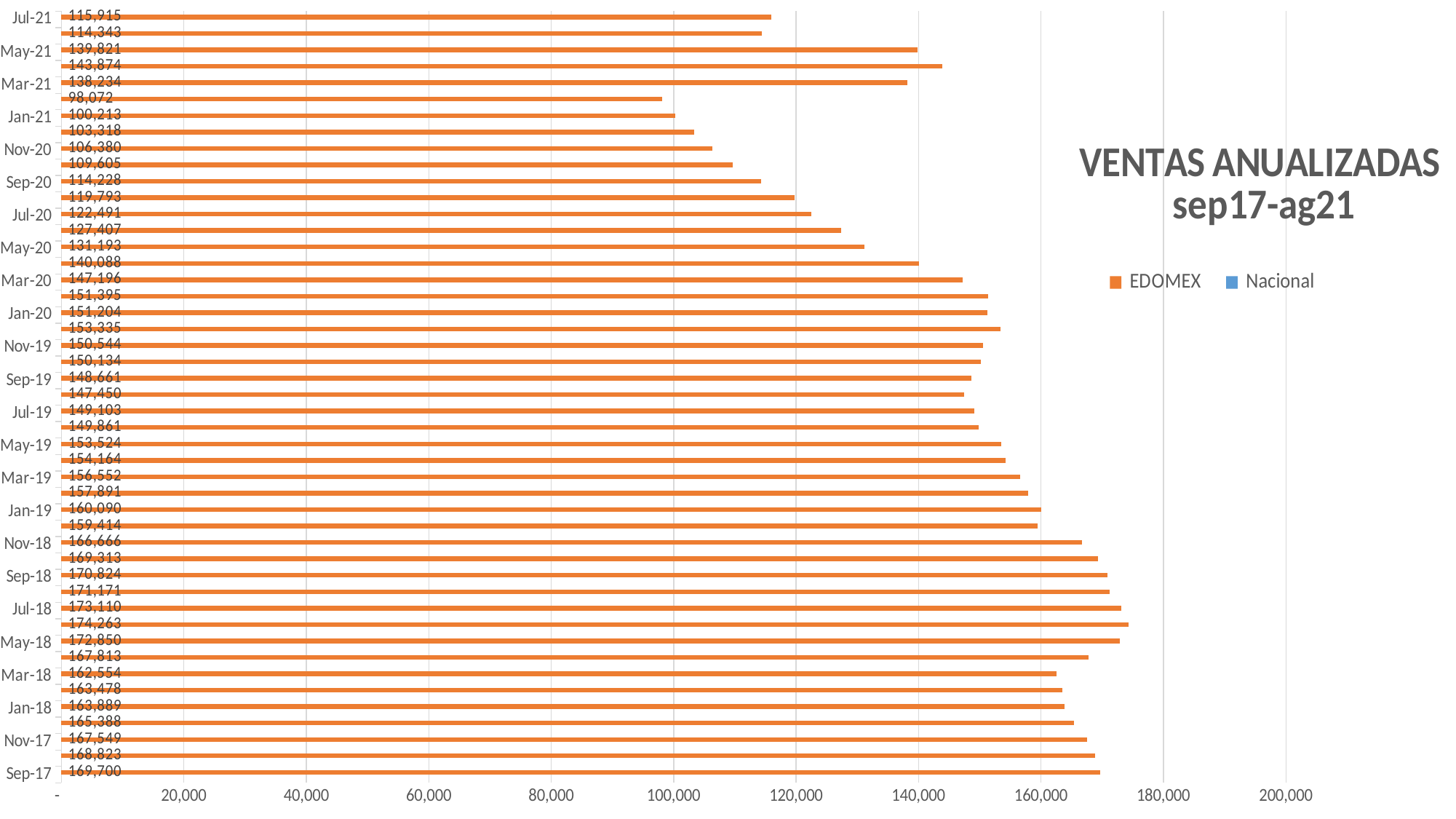
What is the EDOMEX value for Mar-21? 138,234 Do the EDOMEX values increase or decrease from Sep-20 to Jan-21? decrease What is the EDOMEX value for Sep-17? 169,700 Which is larger, the EDOMEX value for Jan-19 or for Jan-21? Jan-19 What is the EDOMEX value for Jul-21? 115,915 What is the difference between the EDOMEX values for Sep-17 and Jul-21? 53,785 How many series does the legend list? 2 What is the title of the chart? VENTAS ANUALIZADAS sep17-ag21 What is the largest EDOMEX value labeled on the chart? 174,263 What is the EDOMEX value for Jan-20? 151,204 What kind of chart is shown on the slide? bar chart Is the EDOMEX value for Nov-20 greater or less than 120,000? less